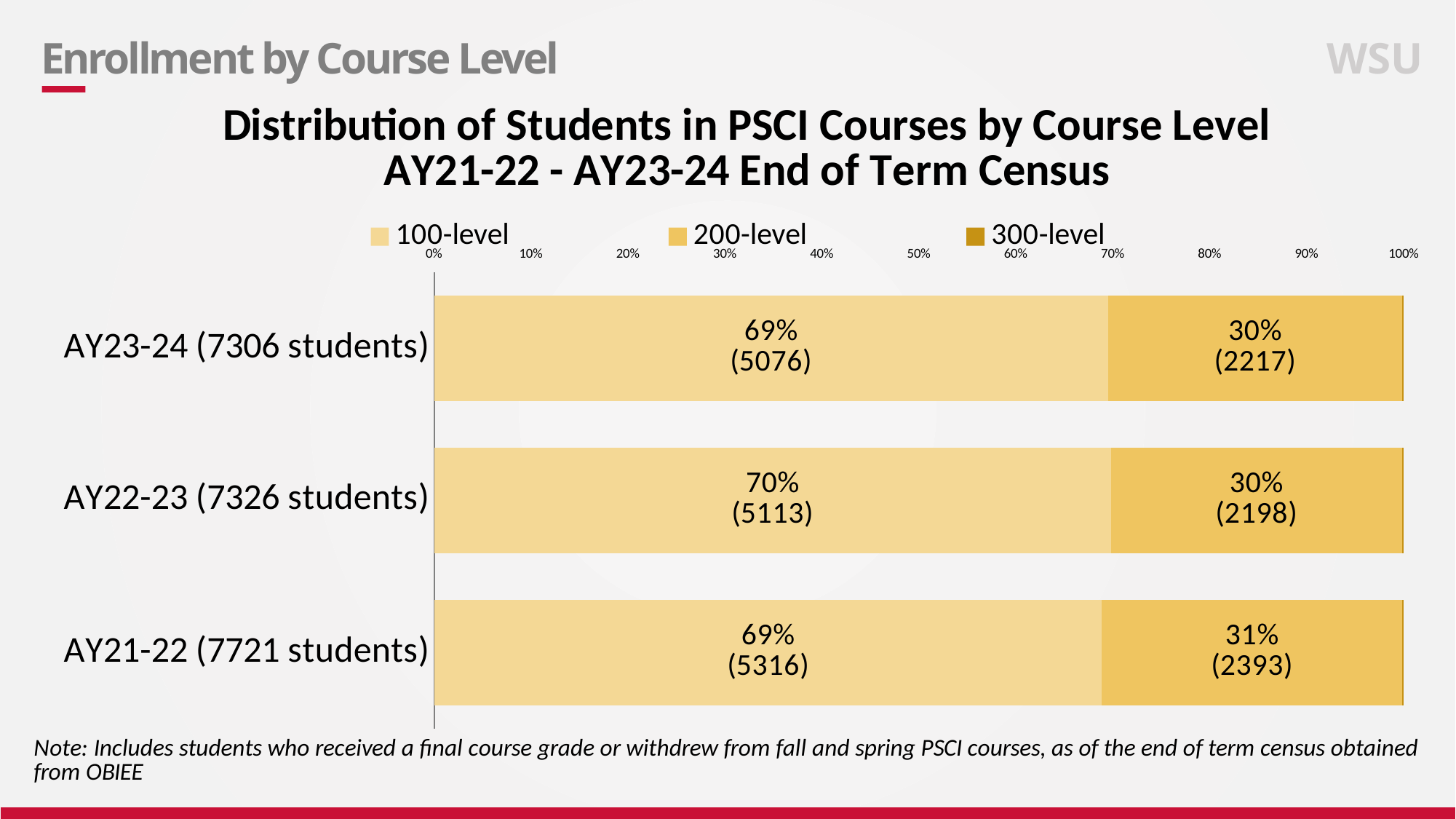
What is the total number of students shown for AY22-23? 7326 students What percentage of students in AY21-22 were in 200-level courses? 31% How many academic years (bars) are plotted in the chart? 3 What is the difference in the number of 200-level students between AY21-22 and AY23-24? 176 What percentage of students in AY23-24 were in 100-level courses? 69% Which academic year had the highest number of students in 100-level courses? AY21-22 How many students were in 100-level courses in AY21-22? 5316 What kind of chart is shown on the slide? stacked bar chart How many students were in 200-level courses in AY22-23? 2198 Which academic year had the lowest number of students in 200-level courses? AY22-23 Which is larger: the number of 100-level students in AY22-23 or in AY23-24? AY22-23 How many series does the legend list? 3